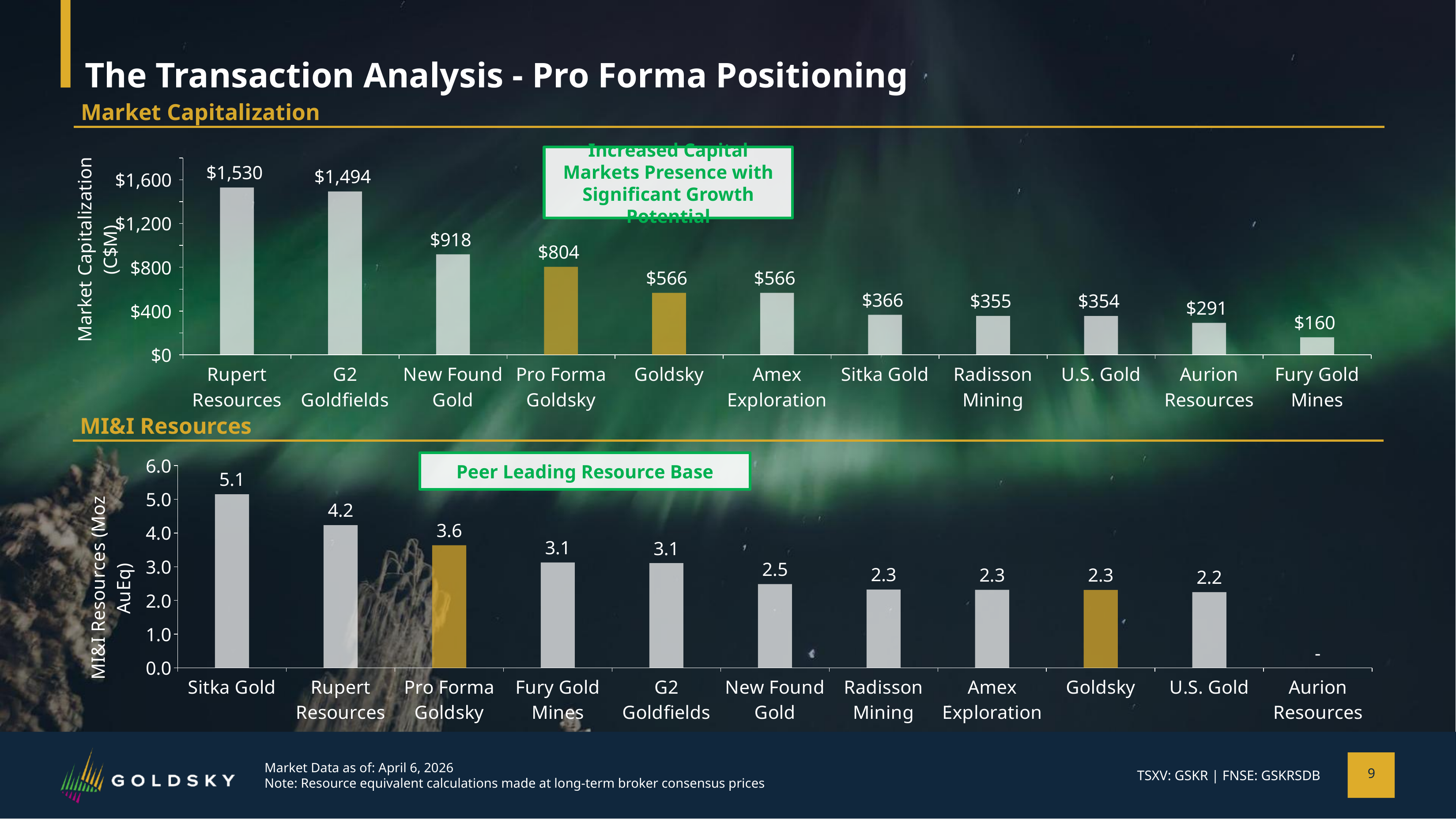
In the Market Capitalization chart, which company has the highest market capitalization? Rupert Resources In the MI&I Resources chart, what is the MI&I resource value for Pro Forma Goldsky? 3.6 In the MI&I Resources chart, what is the text in the green callout box above the bars? Peer Leading Resource Base In the Market Capitalization chart, how many companies are shown? 11 What type of chart is the Market Capitalization chart? Bar chart In the MI&I Resources chart, what is the MI&I resource value for U.S. Gold? 2.2 In the Market Capitalization chart, which is larger, the market capitalization of New Found Gold or Amex Exploration? New Found Gold In the Market Capitalization chart, what is the difference between the market capitalization of Pro Forma Goldsky and Goldsky? $238 In the Market Capitalization chart, which company has the lowest market capitalization? Fury Gold Mines In the MI&I Resources chart, which company has the highest MI&I resources? Sitka Gold In the Market Capitalization chart, what is the market capitalization of Pro Forma Goldsky? $804 In the MI&I Resources chart, what is the difference between the MI&I resources of Sitka Gold and Rupert Resources? 0.9